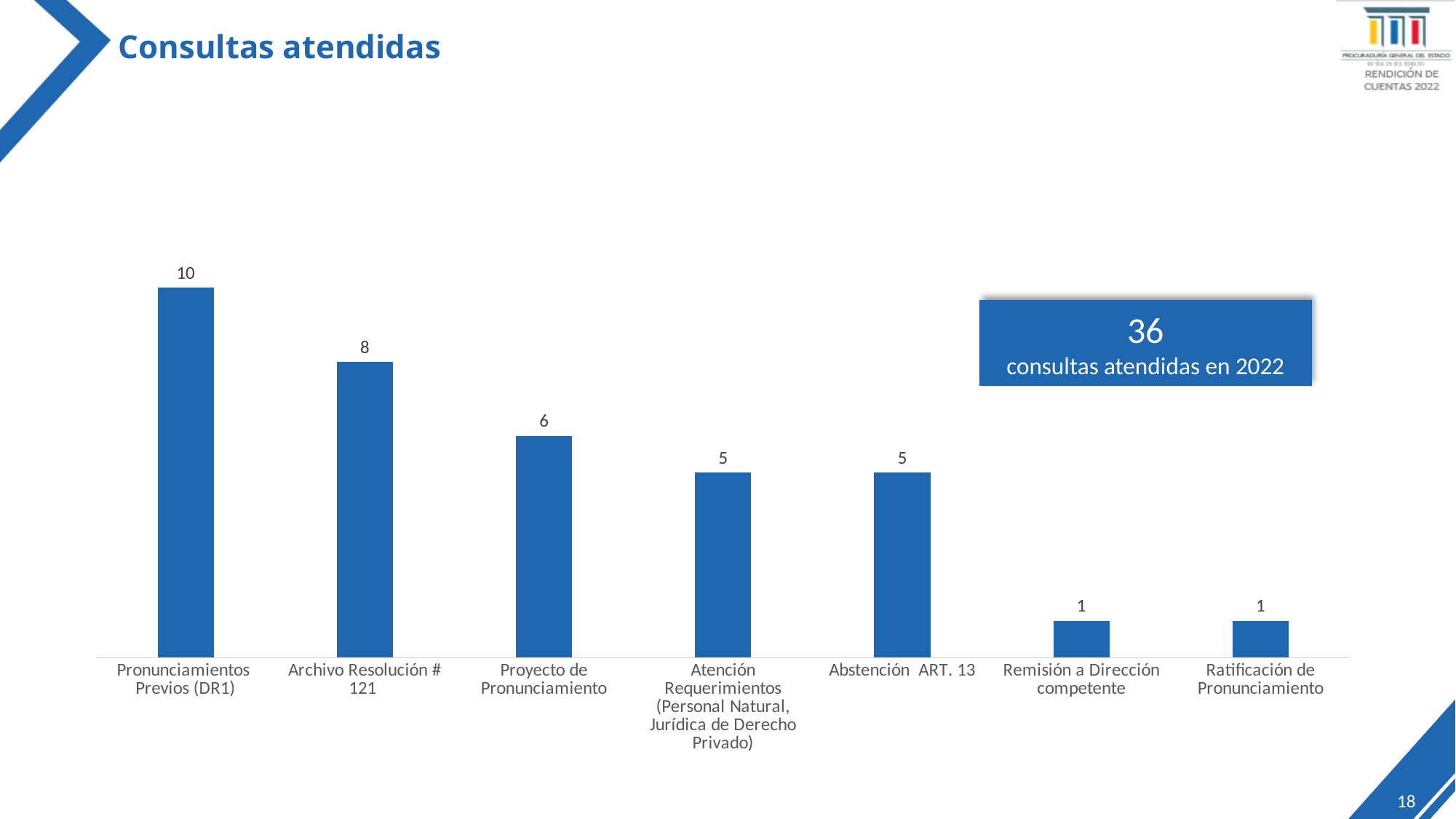
What is the value for Pronunciamientos Previos (DR1)? 10 What is the value for Abstención ART. 13? 5 What is the value for Archivo Resolución # 121? 8 What kind of chart is shown on the slide? Bar chart Which is larger, the value for Proyecto de Pronunciamiento or the value for Abstención ART. 13? Proyecto de Pronunciamiento Do the values rise or fall from left to right across the categories? Fall What is the title of the slide containing the chart? Consultas atendidas How many categories are shown in the chart? 7 Which category has the highest value? Pronunciamientos Previos (DR1) What is the value for Proyecto de Pronunciamiento? 6 What is the value for Remisión a Dirección competente? 1 What is the difference between the values for Pronunciamientos Previos (DR1) and Archivo Resolución # 121? 2